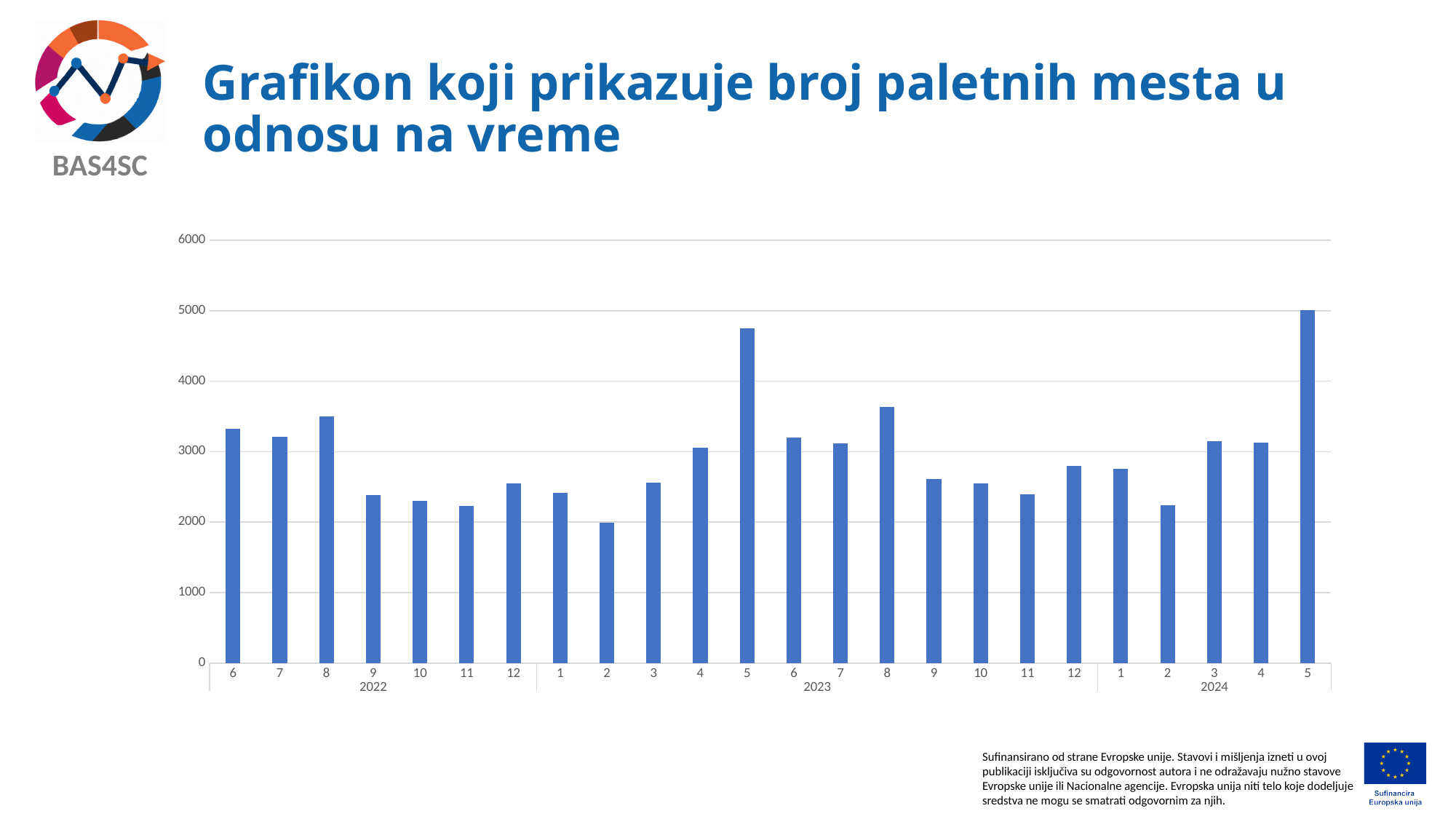
Is the value for month 8 of 2023 greater or less than 3000? greater What kind of chart is shown on the slide? bar chart How many bars (months) are plotted in the chart? 24 Do the values rise or fall from month 8 to month 11 of 2022? fall Is the value for month 2 of 2024 greater or less than 3000? less Is the value for month 8 of 2022 greater or less than 3000? greater Which month has the lowest value in the chart? 2 (2023) Which is larger, the value for month 5 of 2023 or month 8 of 2023? month 5 of 2023 Which month has the highest value in the chart? 5 (2024) Which is larger, the value for month 8 of 2022 or month 9 of 2022? month 8 of 2022 What is the title of the slide containing the chart? Grafikon koji prikazuje broj paletnih mesta u odnosu na vreme